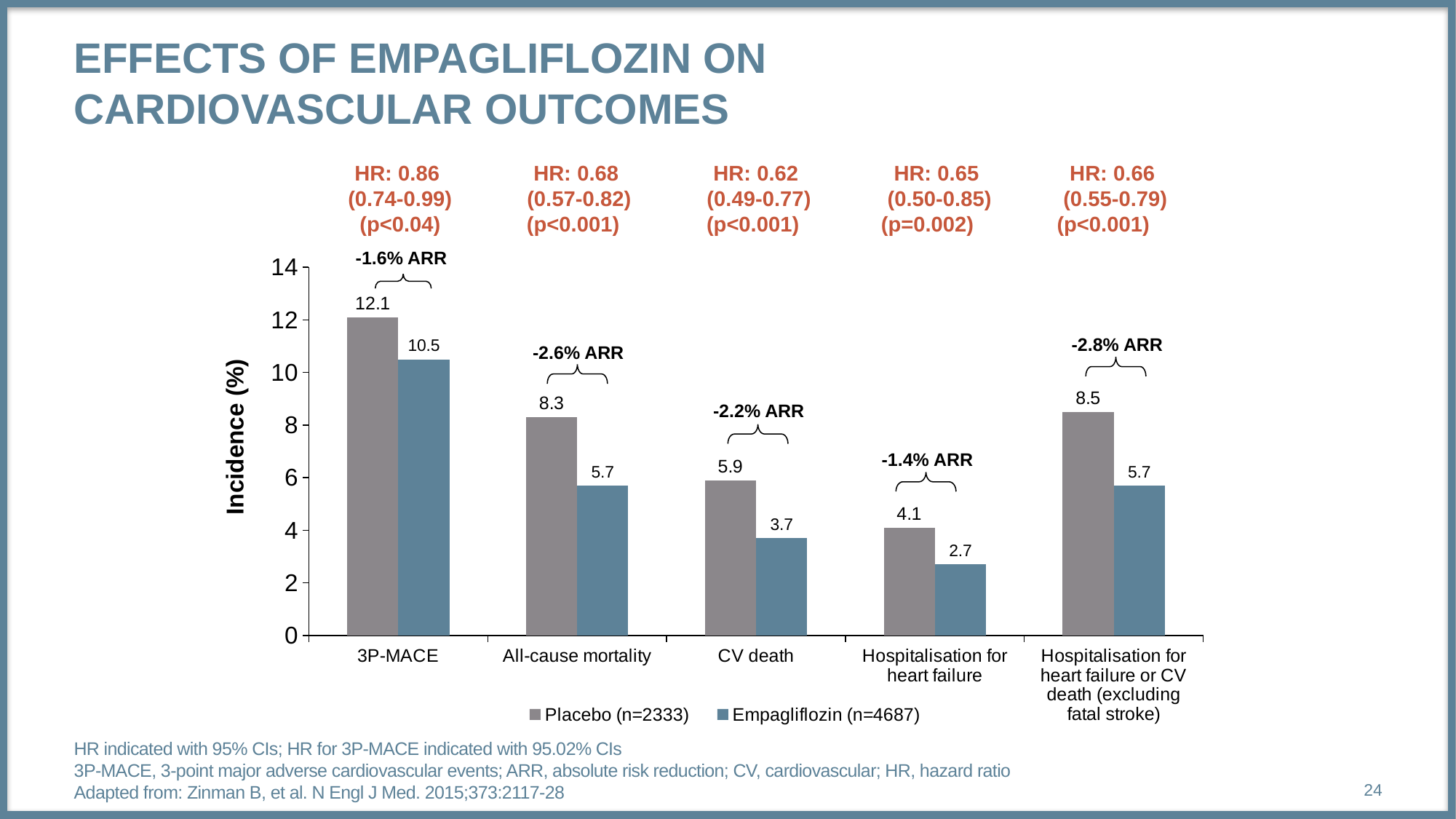
What is the incidence for Placebo in the 3P-MACE category? 12.1 Which category has the highest Placebo incidence? 3P-MACE What is the incidence for Empagliflozin in the Hospitalisation for heart failure category? 2.7 What is the hazard ratio shown above the CV death category? 0.62 How many outcome categories are shown on the x axis? 5 Which category has the lowest Empagliflozin incidence? Hospitalisation for heart failure Which is larger: the Placebo incidence for CV death or the Empagliflozin incidence for All-cause mortality? Placebo incidence for CV death What kind of chart is shown on the slide? Bar chart What is the label of the y axis? Incidence (%) What is the difference between the Placebo and Empagliflozin incidence for All-cause mortality? 2.6 What is the incidence for Empagliflozin in the CV death category? 3.7 How many series does the legend list? 2